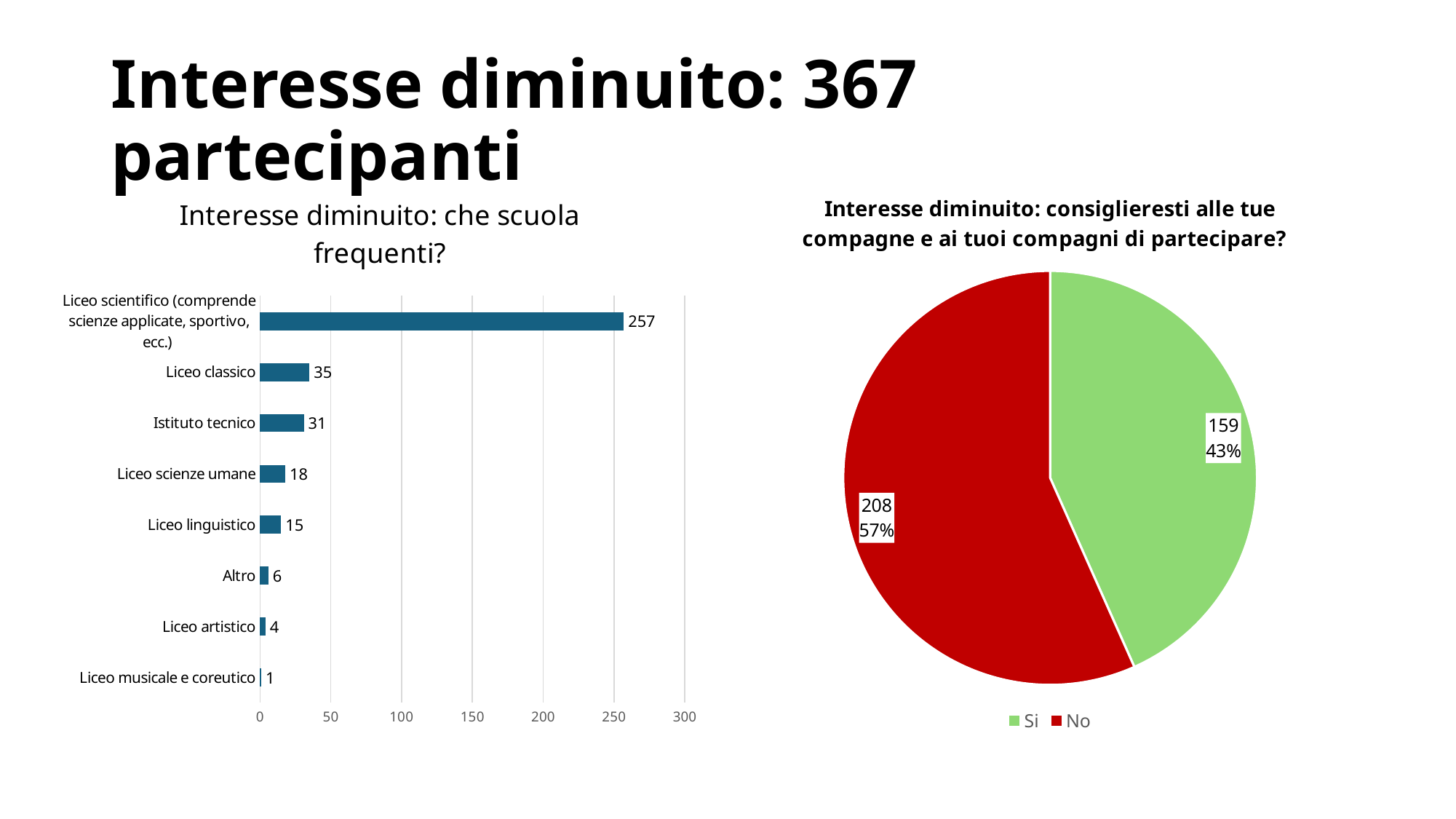
In the bar chart 'Interesse diminuito: che scuola frequenti?', what is the value for Istituto tecnico? 31 In the bar chart 'Interesse diminuito: che scuola frequenti?', is the value for Liceo scientifico greater or less than 250? greater In the bar chart 'Interesse diminuito: che scuola frequenti?', what is the difference between Liceo scienze umane and Liceo linguistico? 3 What kind of chart is 'Interesse diminuito: che scuola frequenti?'? bar chart How many categories are shown in the bar chart 'Interesse diminuito: che scuola frequenti?'? 8 In the bar chart 'Interesse diminuito: che scuola frequenti?', which category has the lowest value? Liceo musicale e coreutico In the bar chart 'Interesse diminuito: che scuola frequenti?', what is the value for Liceo classico? 35 In the bar chart 'Interesse diminuito: che scuola frequenti?', which is larger, Altro or Liceo artistico? Altro In the pie chart on the right, what share of the pie is 'Si'? 43% In the bar chart 'Interesse diminuito: che scuola frequenti?', which category has the highest value? Liceo scientifico (comprende scienze applicate, sportivo, ecc.) How many entries does the legend of the pie chart on the right list? 2 In the pie chart on the right, what is the value for 'No'? 208